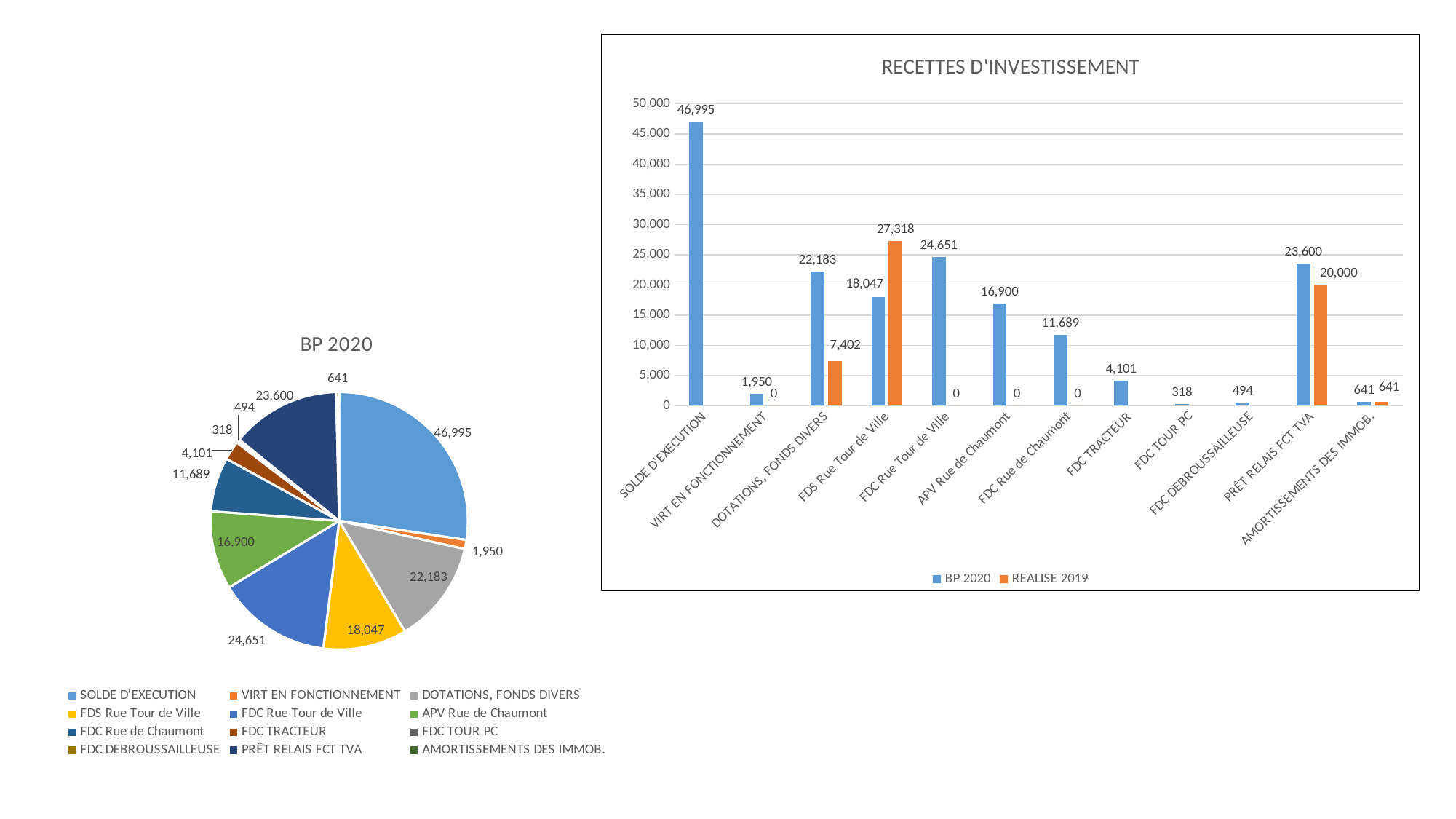
In the RECETTES D'INVESTISSEMENT chart, which category has the highest BP 2020 value? SOLDE D'EXECUTION In the RECETTES D'INVESTISSEMENT chart, what is the REALISE 2019 value for DOTATIONS, FONDS DIVERS? 7,402 What kind of chart is the RECETTES D'INVESTISSEMENT chart? Bar chart In the RECETTES D'INVESTISSEMENT chart, what is the BP 2020 value for SOLDE D'EXECUTION? 46,995 In the BP 2020 pie chart, which is larger: APV Rue de Chaumont or FDC Rue de Chaumont? APV Rue de Chaumont In the RECETTES D'INVESTISSEMENT chart, which category has the lowest BP 2020 value? FDC TOUR PC In the RECETTES D'INVESTISSEMENT chart, what is the REALISE 2019 value for FDS Rue Tour de Ville? 27,318 In the BP 2020 pie chart, what is the value for FDC Rue Tour de Ville? 24,651 In the RECETTES D'INVESTISSEMENT chart, what is the difference between the BP 2020 and REALISE 2019 values for PRÊT RELAIS FCT TVA? 3,600 In the RECETTES D'INVESTISSEMENT chart, for FDS Rue Tour de Ville, which is larger: BP 2020 or REALISE 2019? REALISE 2019 How many series does the legend of the RECETTES D'INVESTISSEMENT chart list? 2 How many slices does the BP 2020 pie chart have? 12